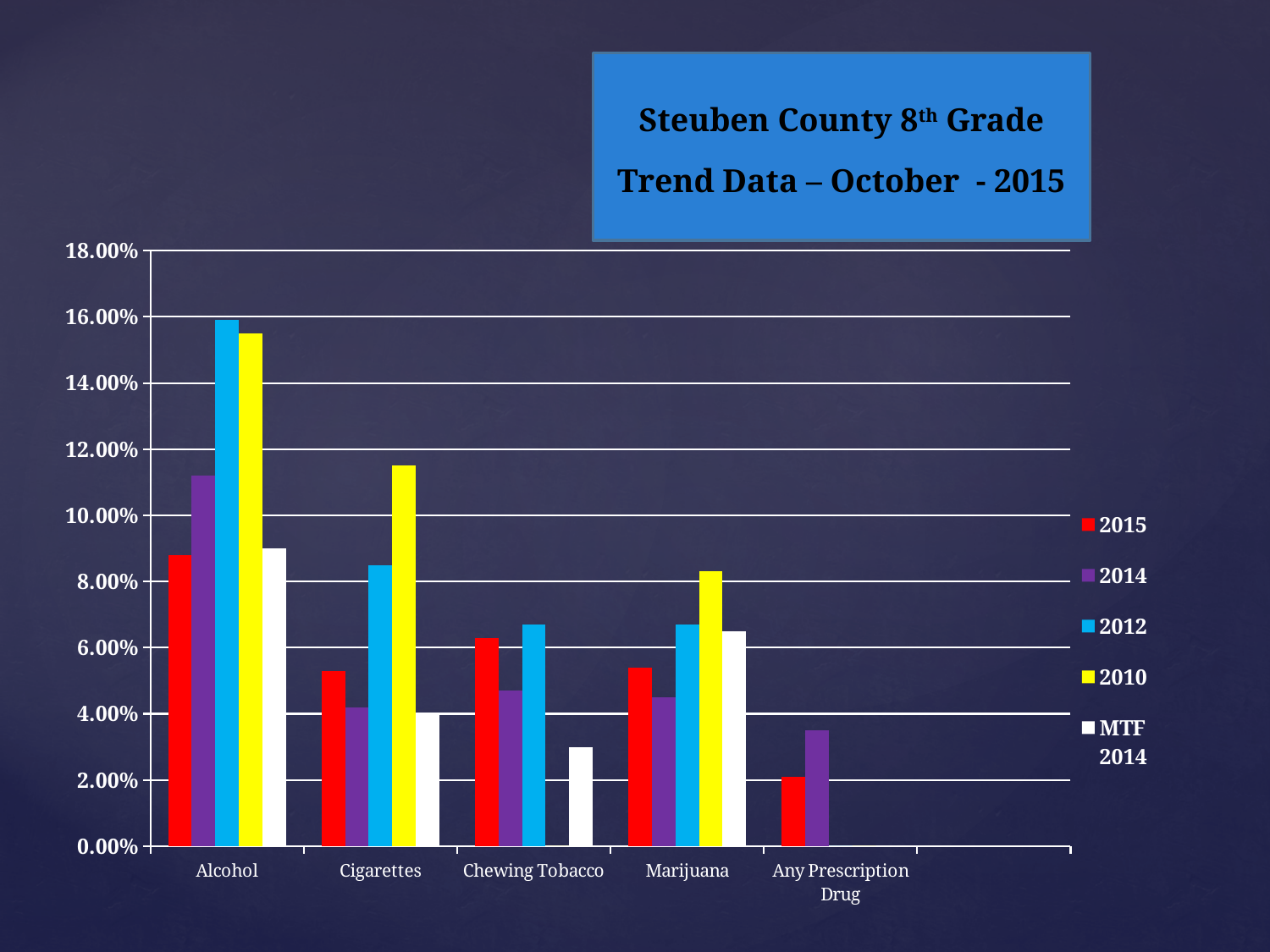
Which category has the highest 2012 bar? Alcohol What kind of chart is shown on the slide? bar chart For Cigarettes, which is larger: the 2012 value or the 2014 value? 2012 How many categories are shown on the x axis? 5 Is the MTF 2014 value for Chewing Tobacco greater or less than 4.00%? less Is the 2012 value for Marijuana greater or less than 8.00%? less Which category has the lowest 2015 bar? Any Prescription Drug For Any Prescription Drug, which is larger: the 2015 value or the 2014 value? 2014 How many series does the legend list? 5 Is the 2015 value for Alcohol greater or less than 8.00%? greater What colour represents the 2010 series in the legend? yellow